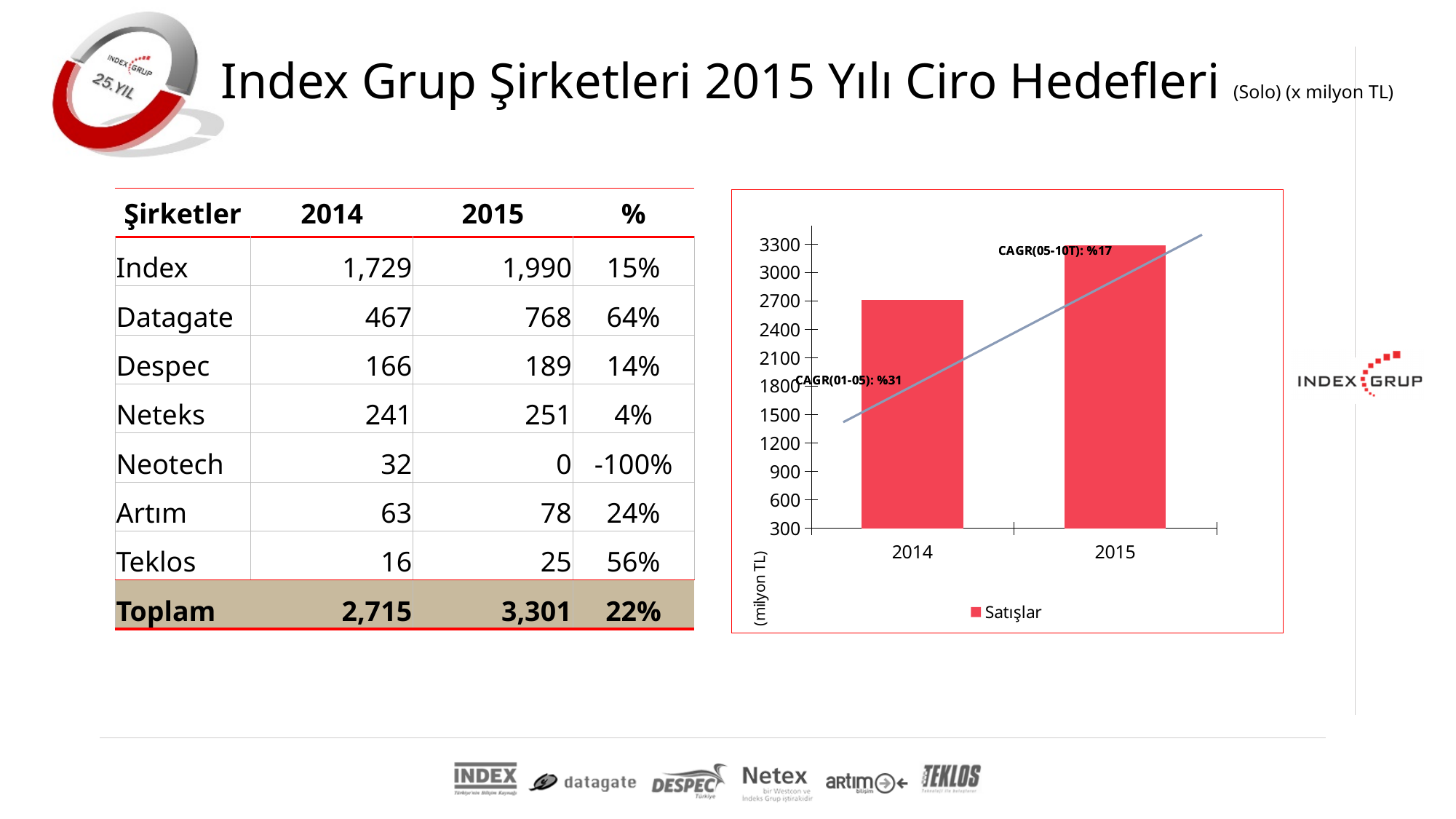
How many categories are shown on the x axis of the bar chart? 2 What unit label is written along the vertical axis of the bar chart? (milyon TL) Do the bar values rise or fall from 2014 to 2015 in the bar chart? rise How many series does the legend of the bar chart list? 1 What is the name of the series shown in the legend of the bar chart? Satışlar In the bar chart, is the value for 2015 greater or less than 3000? greater In the bar chart, is the value for 2014 greater or less than 3000? less In the bar chart, is the value for 2014 greater or less than 2400? greater What kind of chart is shown on the right side of the slide? bar chart Which year has the lowest bar in the bar chart? 2014 Which year has the taller bar in the bar chart, 2014 or 2015? 2015